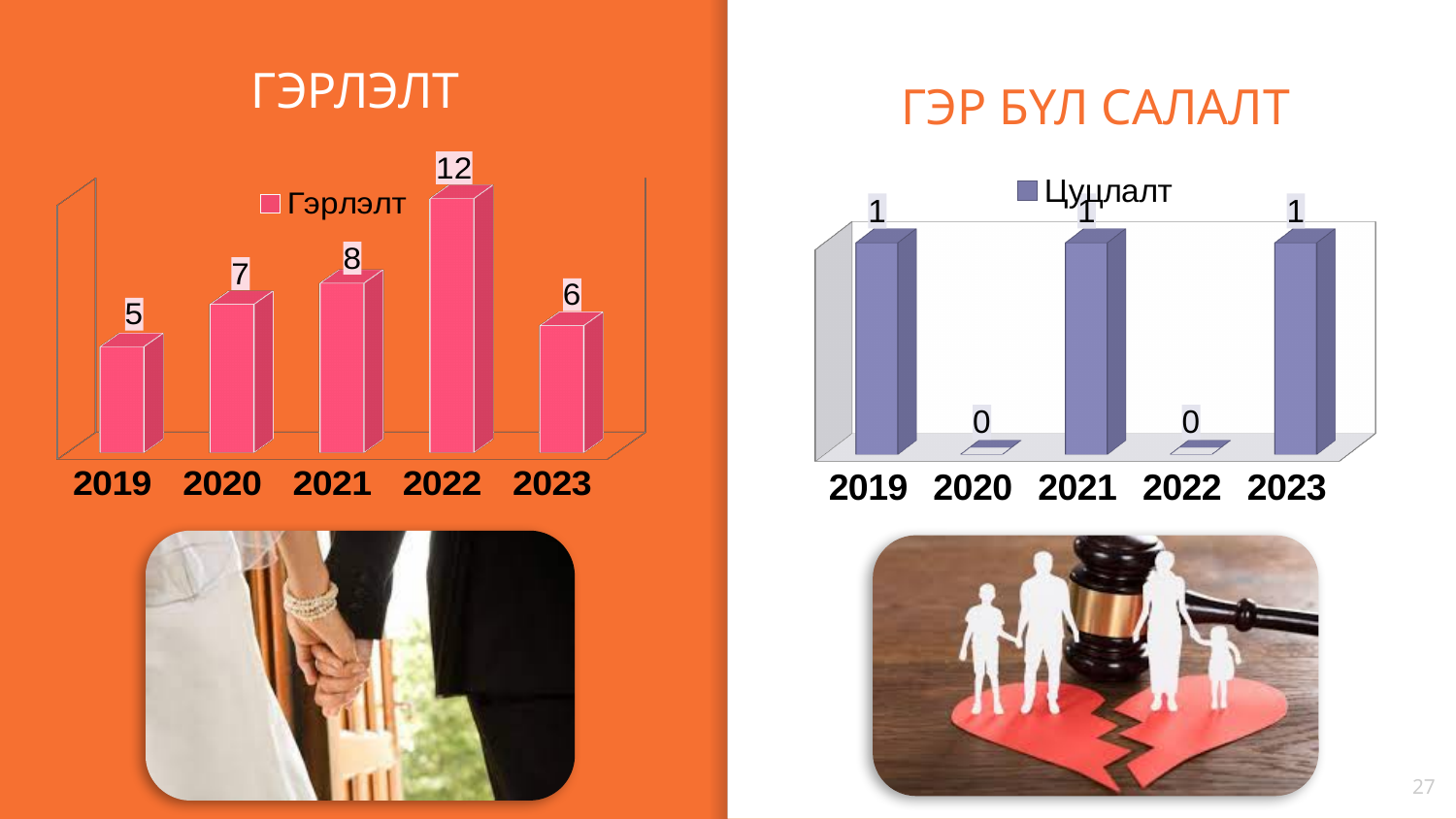
In the ГЭРЛЭЛТ chart on the left, how many years are shown on the x axis? 5 In the ГЭРЛЭЛТ chart on the left, what is the value for 2019? 5 In the ГЭР БҮЛ САЛАЛТ chart on the right, how many years have a value of 0? 2 In the ГЭРЛЭЛТ chart on the left, which year has the larger value, 2020 or 2021? 2021 In the ГЭР БҮЛ САЛАЛТ chart on the right, what is the value for 2020? 0 In the ГЭРЛЭЛТ chart on the left, what is the difference between the values for 2022 and 2023? 6 What is the legend entry of the ГЭР БҮЛ САЛАЛТ chart on the right? Цуцлалт What kind of chart is the ГЭР БҮЛ САЛАЛТ chart on the right? Bar chart In the ГЭР БҮЛ САЛАЛТ chart on the right, what is the value for 2023? 1 In the ГЭРЛЭЛТ chart on the left, what is the value for 2022? 12 In the ГЭРЛЭЛТ chart on the left, which year has the highest value? 2022 In the ГЭРЛЭЛТ chart on the left, which year has the lowest value? 2019